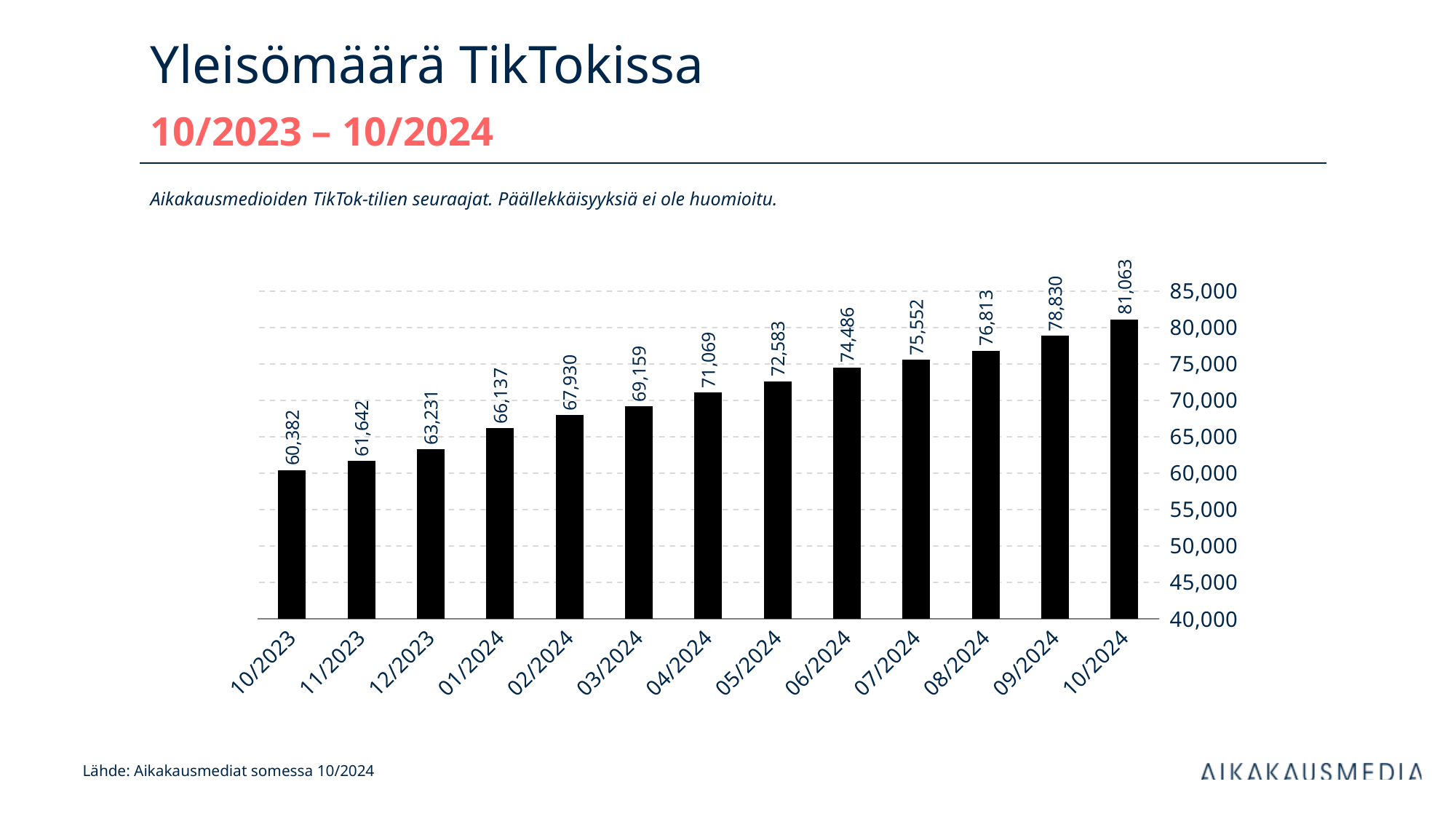
Which month has the lowest value? 10/2023 What is the value for 10/2023? 60,382 Is the value for 06/2024 greater or less than 70,000? greater What is the difference between the values for 09/2024 and 08/2024? 2,017 What kind of chart is shown on the slide? bar chart Which month has the highest value? 10/2024 What is the value for 04/2024? 71,069 Which is larger, the value for 01/2024 or the value for 12/2023? 01/2024 What is the difference between the values for 10/2024 and 10/2023? 20,681 What is the value for 10/2024? 81,063 How many months are shown on the x axis? 13 Do the values rise or fall from 10/2023 to 10/2024? rise